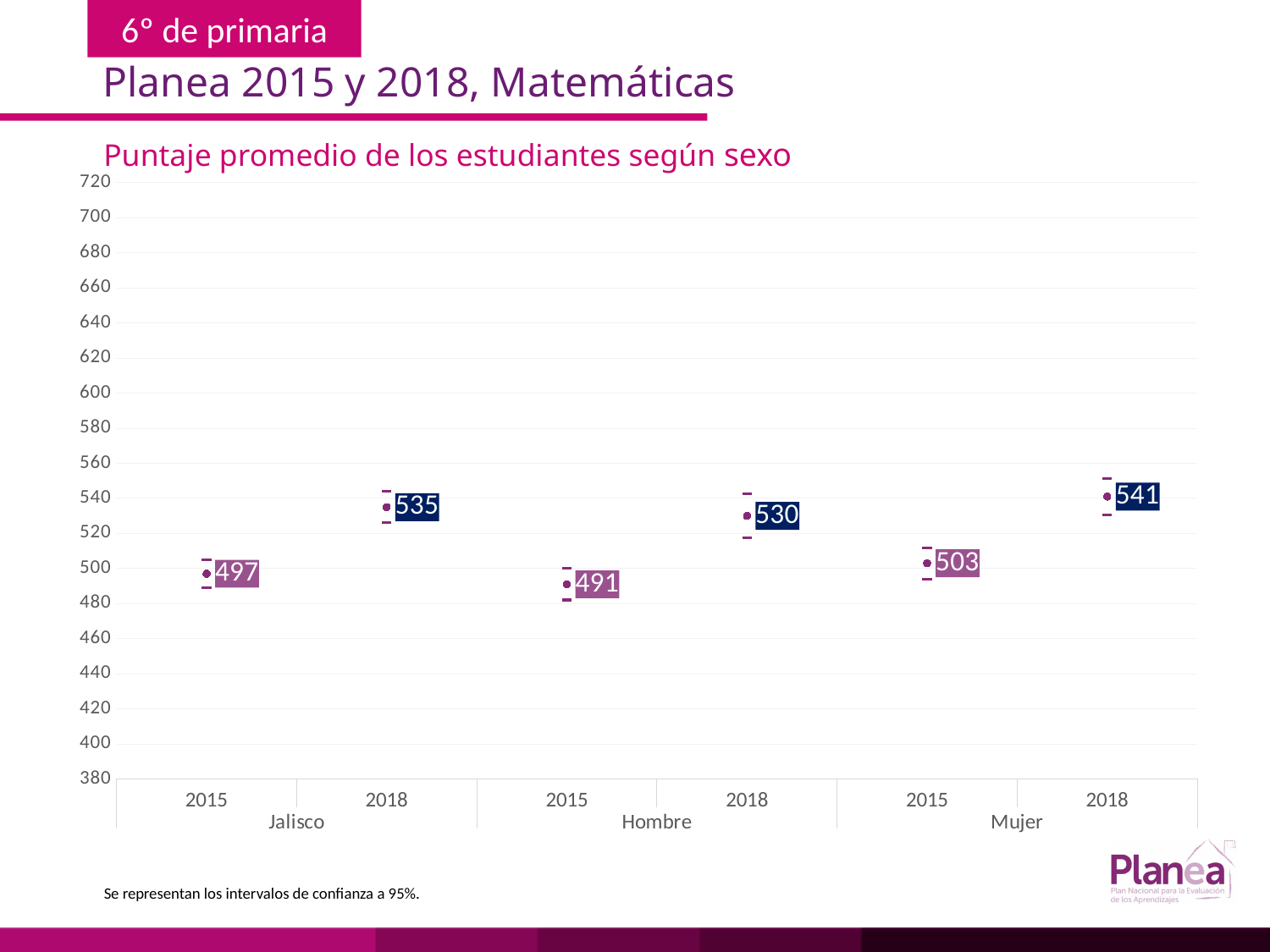
What is the title of the chart? Puntaje promedio de los estudiantes según sexo What is the average score for Jalisco in 2015? 497 What is the difference between the Jalisco scores in 2018 and 2015? 38 What is the average score for Mujer in 2015? 503 Which is larger, the Mujer 2015 score or the Hombre 2015 score? Mujer 2015 What is the average score for Hombre in 2018? 530 Does the score for Hombre rise or fall from 2015 to 2018? rise Is the value for Hombre 2015 greater or less than 500? less What is the difference between the Mujer and Hombre scores in 2018? 11 How many data points are plotted on the chart? 6 Which group and year has the highest average score? Mujer 2018 Which group and year has the lowest average score? Hombre 2015